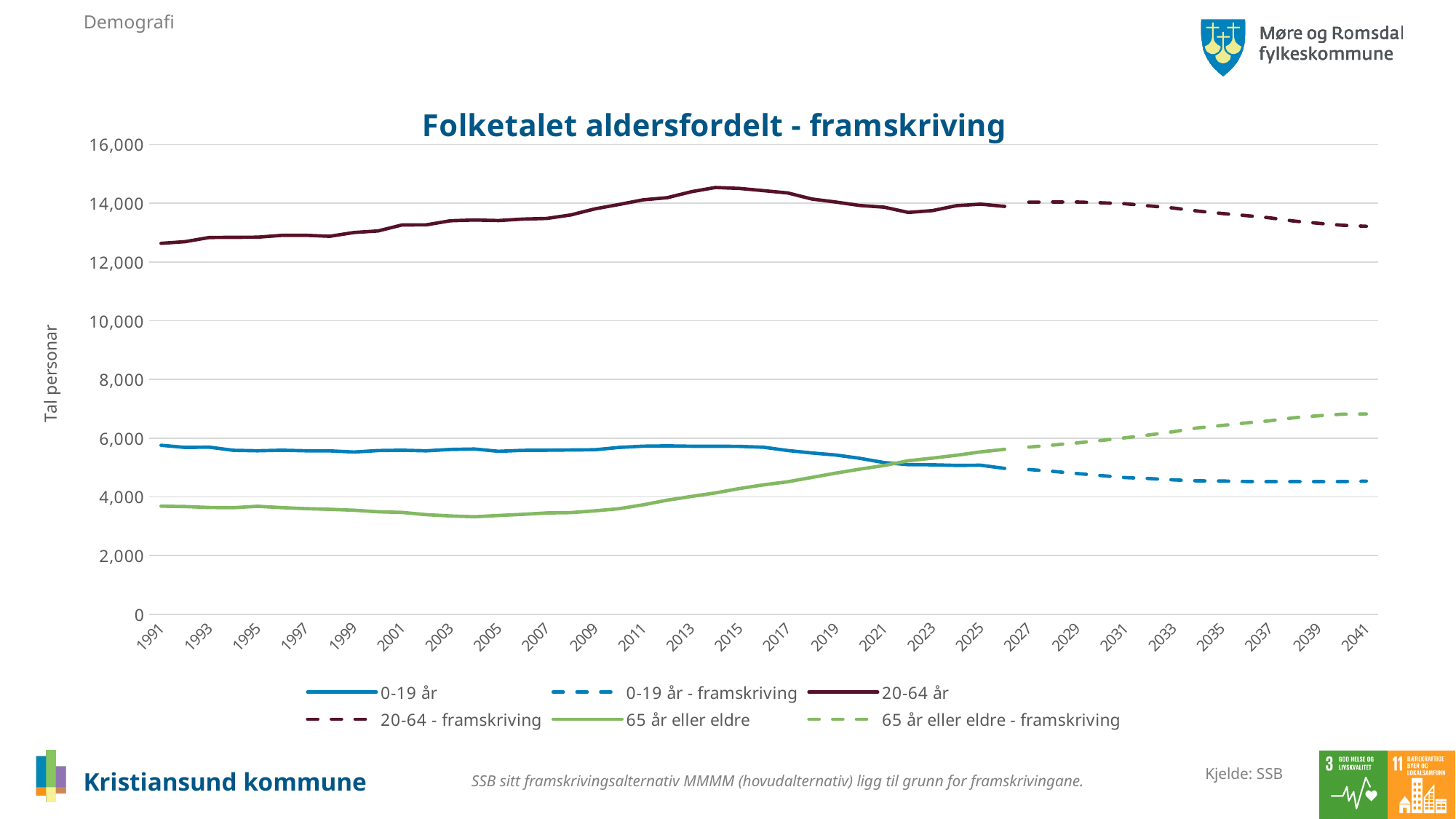
Is the value for 65 år eller eldre in 2004 greater or less than 4,000? less Is the value for 65 år eller eldre - framskriving in 2041 greater or less than 6,000? greater What is the title of the chart? Folketalet aldersfordelt - framskriving In 2041, which is larger: 65 år eller eldre - framskriving or 0-19 år - framskriving? 65 år eller eldre - framskriving What kind of chart is shown on the slide? line chart Does the 65 år eller eldre series rise or fall between 2005 and 2025? rise How many series does the legend list? 6 Which series has the highest values across the whole chart? 20-64 år Is the value for 20-64 år in 2014 greater or less than 14,000? greater Does the 20-64 - framskriving series rise or fall between 2027 and 2041? fall What is the label on the vertical axis? Tal personar